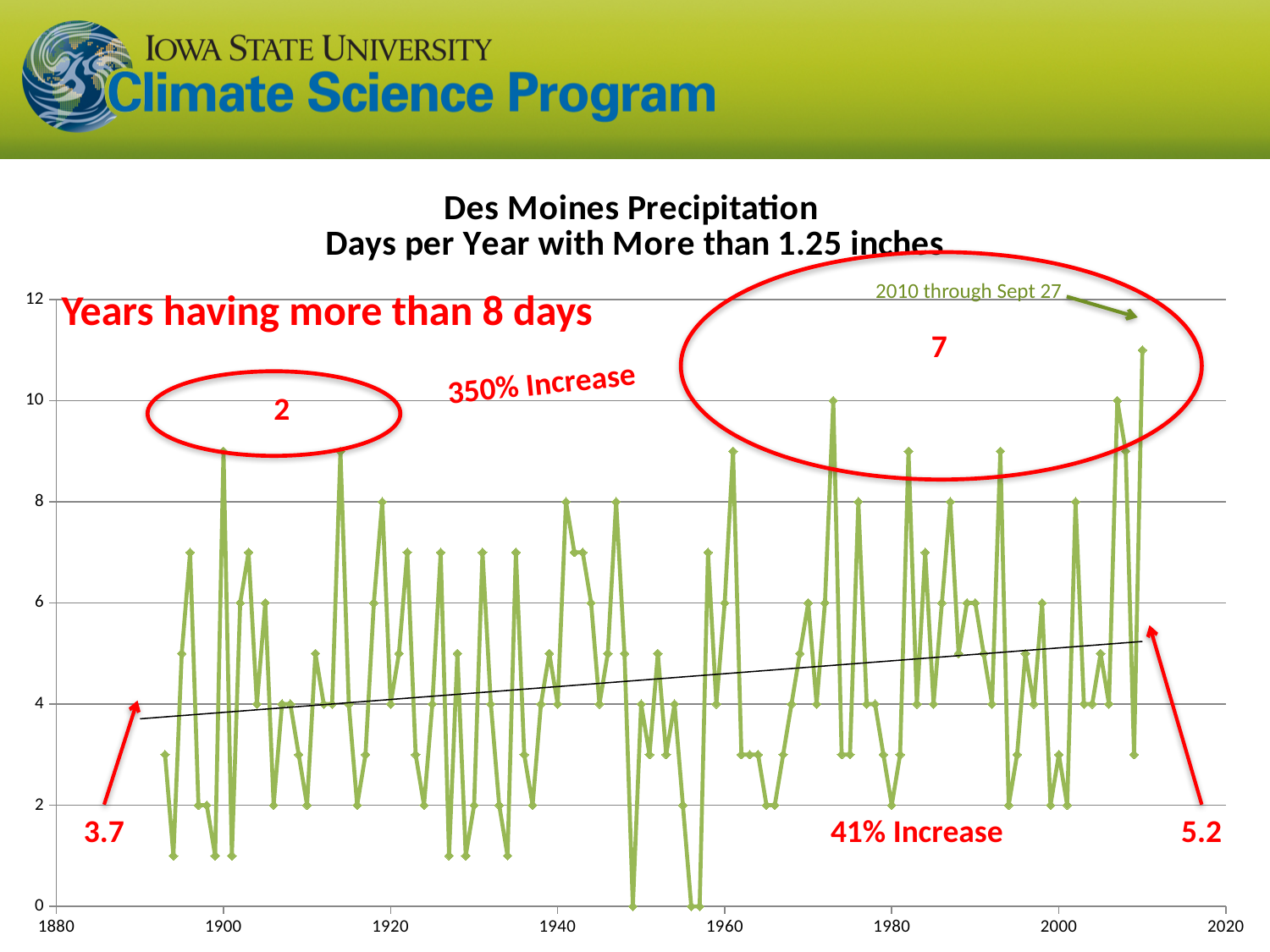
How many years having more than 8 days are circled in the early period (around 1900-1920)? 2 According to the trend line annotation, what is the value at the start of the trend line (around 1890)? 3.7 What percentage increase does the slide give for the number of years having more than 8 days? 350% Increase Does the trend line rise or fall from 1890 to 2010? rises What is the lowest value reached by the line on the chart? 0 According to the trend line annotation, what is the value at the end of the trend line (around 2010)? 5.2 What kind of chart is shown on the slide? line chart By how much does the trend line rise from its start value (3.7) to its end value (5.2)? 1.5 Is the value for 2010 (through Sept 27) greater or less than 10? greater What is the title of the chart? Des Moines Precipitation Days per Year with More than 1.25 inches How many years having more than 8 days are circled in the later period (around 1970-2010)? 7 What percentage increase does the slide give for the trend line? 41% Increase